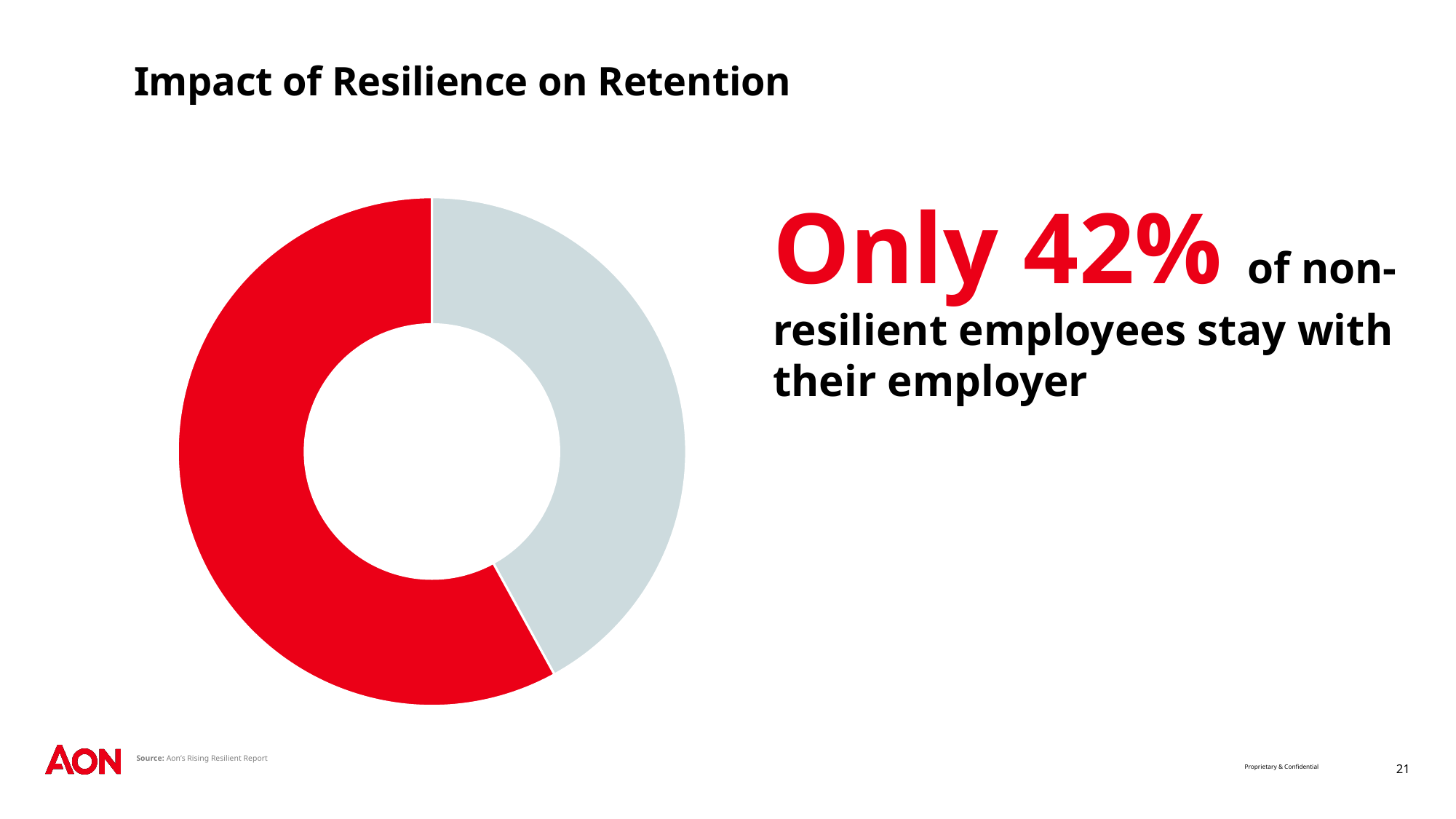
What is the title of the slide containing the donut chart? Impact of Resilience on Retention How many slices does the donut chart have? 2 Is the grey slice of the donut chart greater or less than half of the whole? less Is the red slice of the donut chart greater or less than half of the whole? greater What kind of chart is shown on the slide? Pie chart (donut) Which slice of the donut chart is larger, the red one or the grey one? The red one According to the slide, what percentage of non-resilient employees stay with their employer? 42% What two colours are used for the slices of the donut chart? Red and grey